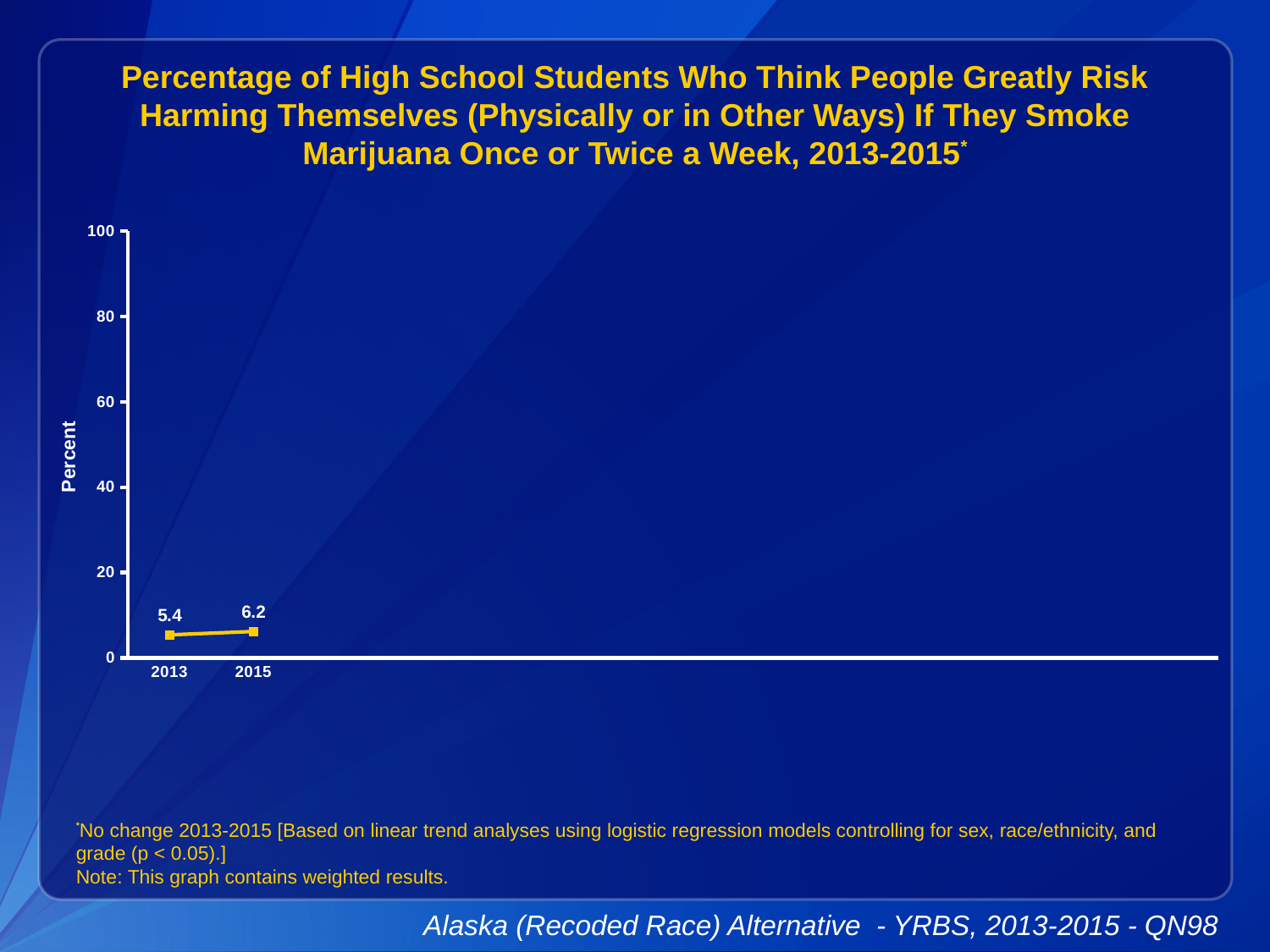
Which year has the higher value? 2015 What is the maximum value shown on the y axis? 100 What is the label on the y axis? Percent What is the value for 2013? 5.4 Is the value for 2015 greater or less than 20? less What is the difference between the 2015 and 2013 values? 0.8 How many data points are plotted on the chart? 2 What kind of chart is shown on the slide? line chart Which year has the lower value? 2013 Do the values rise or fall from 2013 to 2015? rise What is the value for 2015? 6.2